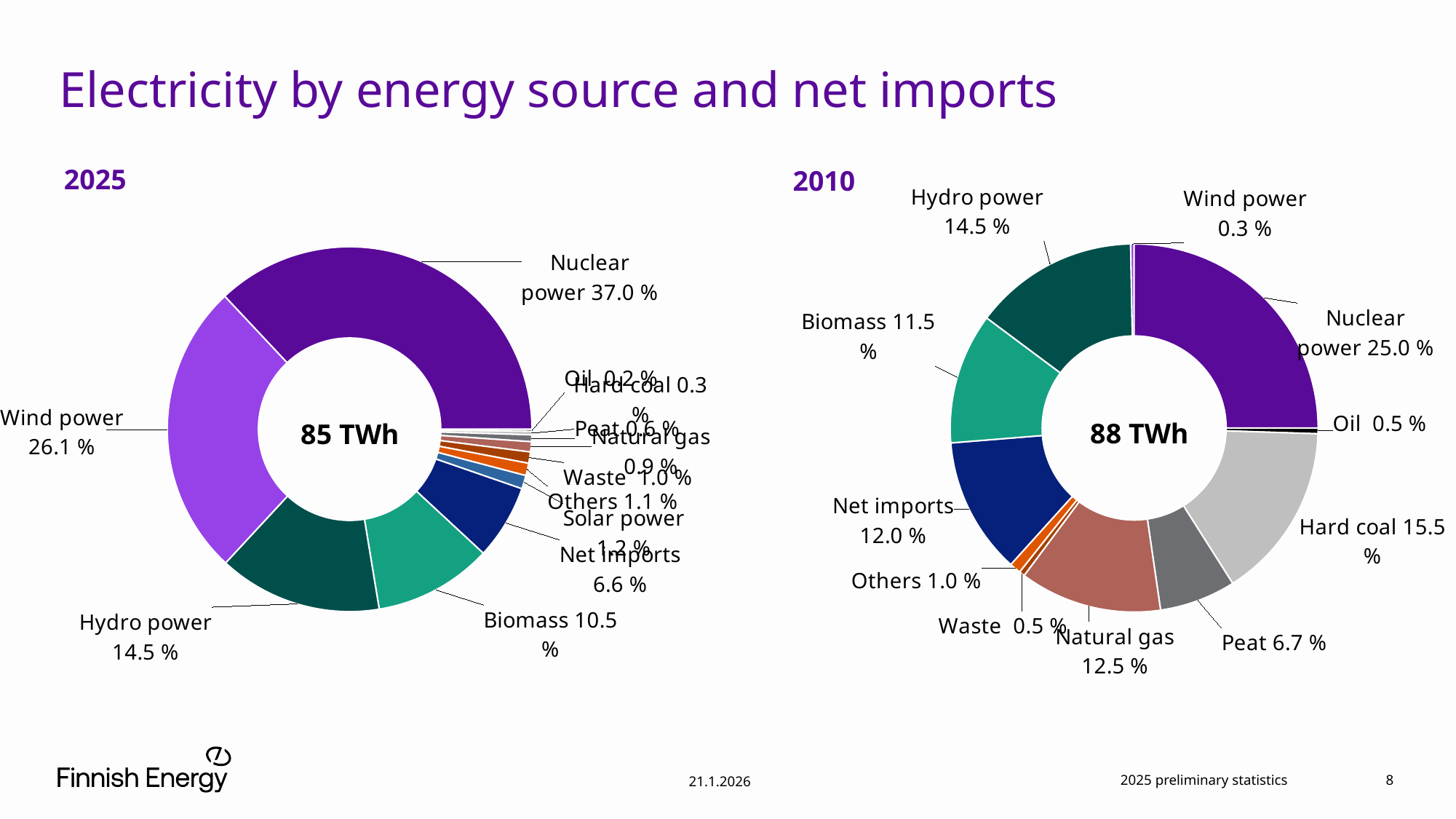
In the 2010 chart, what share of electricity comes from hard coal? 15.5 % In the 2025 chart, what is the total electricity shown in the centre of the donut? 85 TWh What is the difference between the nuclear power share in the 2025 chart and the nuclear power share in the 2010 chart? 12.0 % How many energy source categories are labelled in the 2010 chart? 11 In the 2025 chart, which energy source has the largest share? Nuclear power In the 2010 chart, what is the total electricity shown in the centre of the donut? 88 TWh In the 2025 chart, what share of electricity comes from nuclear power? 37.0 % In the 2010 chart, which energy source has the smallest share? Wind power In the 2010 chart, which is larger: the share of natural gas or the share of peat? Natural gas What kind of chart is used for the 2025 data? Donut (pie) chart In the 2010 chart, what share of electricity comes from net imports? 12.0 % In the 2025 chart, what share of electricity comes from wind power? 26.1 %